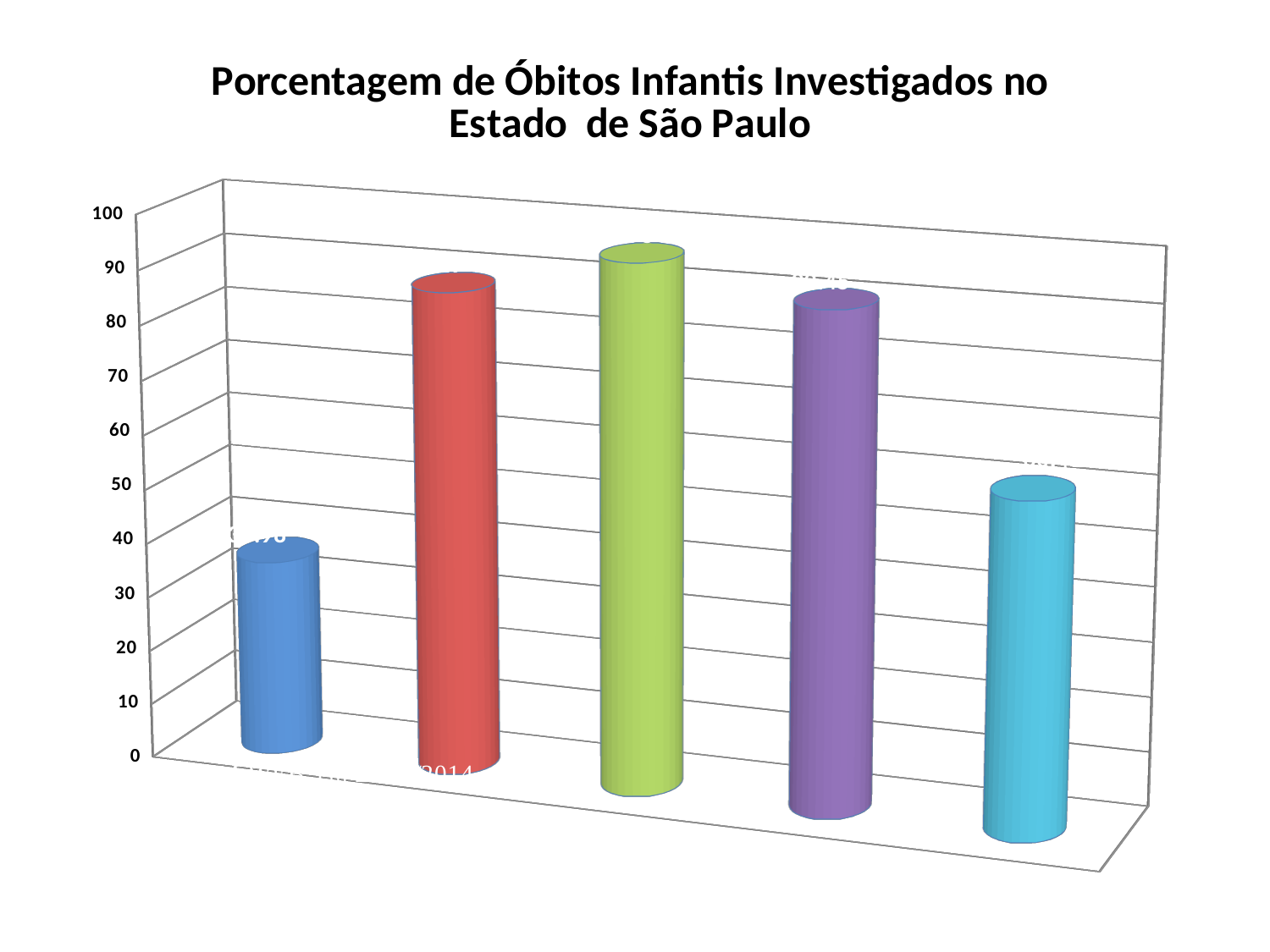
Is the value for the third (green) bar greater or less than 60? greater Which is larger, the value of the red bar or the value of the light blue (fifth) bar? the red bar Is the value for the first (blue) bar greater or less than 50? less Which bar is the tallest in the chart? the third (green) bar Is the value for the fourth (purple) bar greater or less than 60? greater Which is larger, the value of the green bar or the value of the blue bar? the green bar What is the maximum value shown on the vertical axis? 100 How many bars are plotted in the chart? 5 What is the title of the chart? Porcentagem de Óbitos Infantis Investigados no Estado de São Paulo What kind of chart is shown on the slide? bar chart Which bar is the shortest in the chart? the first (blue) bar